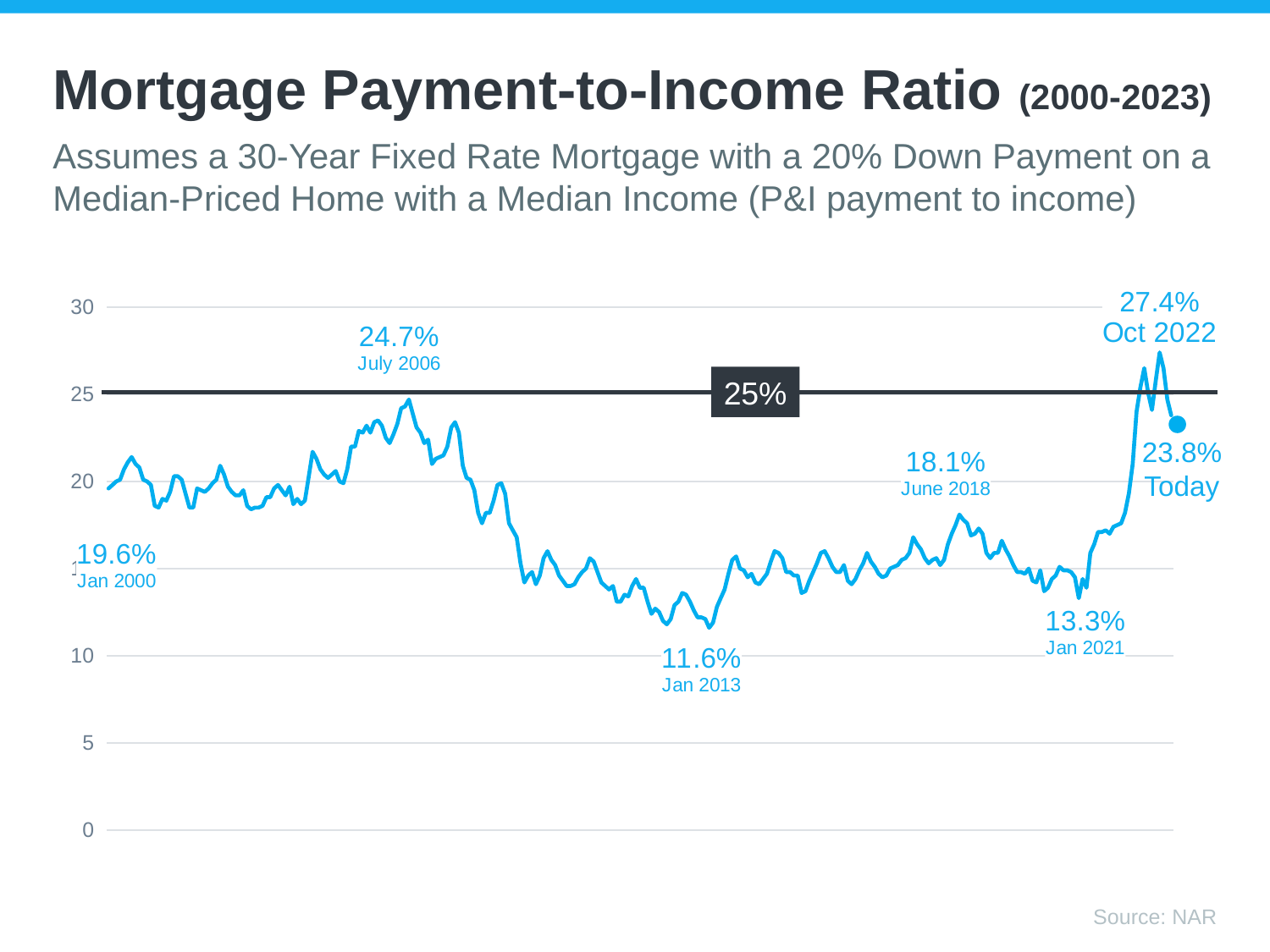
What kind of chart is shown on the slide? line chart What was the mortgage payment-to-income ratio in July 2006? 24.7% What was the mortgage payment-to-income ratio in Jan 2000? 19.6% What was the mortgage payment-to-income ratio in Oct 2022? 27.4% What value does the horizontal reference line on the chart mark? 25% What was the mortgage payment-to-income ratio in Jan 2013? 11.6% What is the difference between the Oct 2022 ratio and the Today ratio? 3.6% Which is larger, the ratio in June 2018 or the ratio in Jan 2021? June 2018 Did the ratio rise or fall between Jan 2021 and Oct 2022? rise What is the mortgage payment-to-income ratio labeled as 'Today'? 23.8% Which labeled point on the chart has the highest ratio? Oct 2022 Which labeled point on the chart has the lowest ratio? Jan 2013